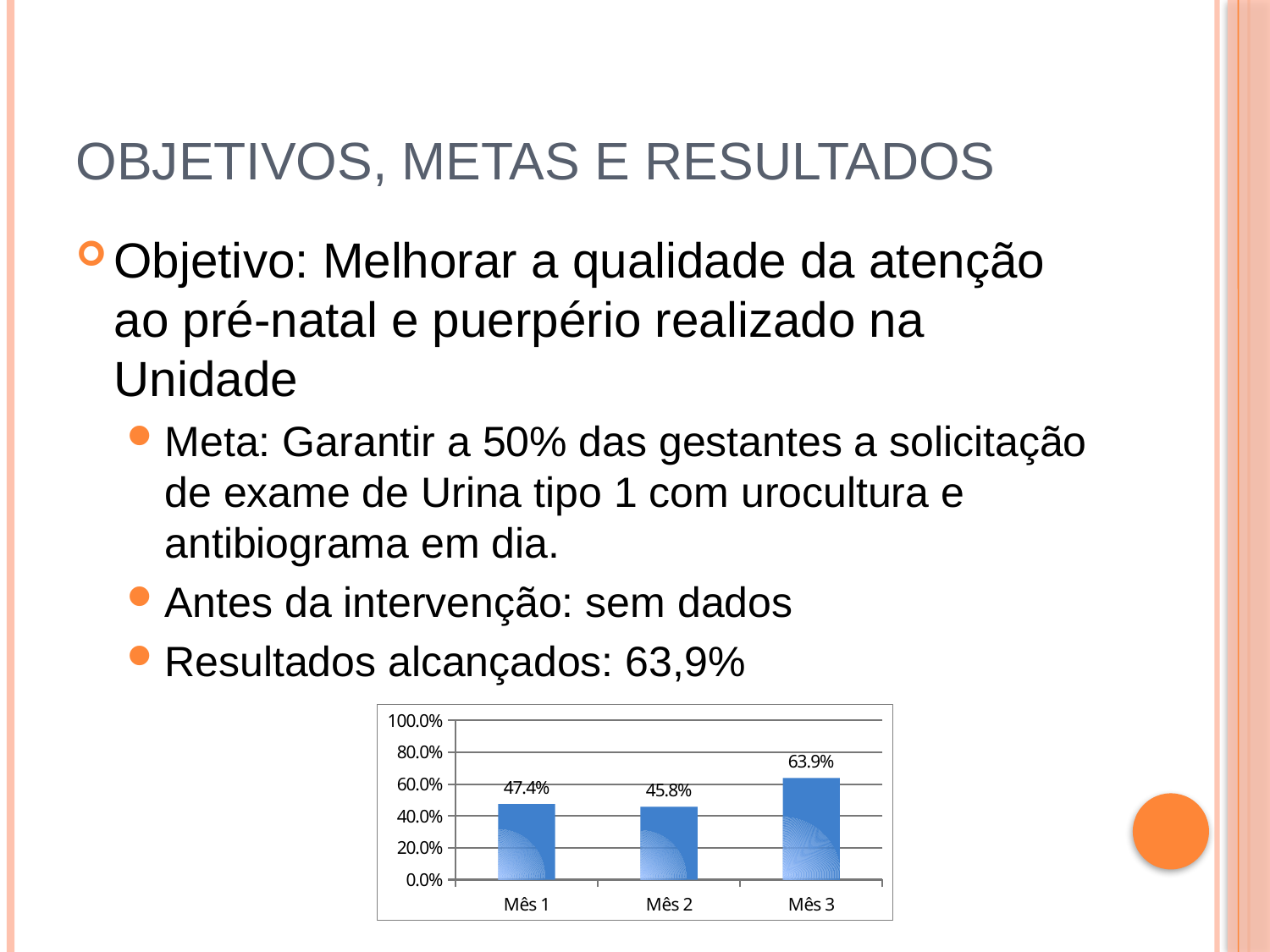
Which is larger, the value for Mês 3 or the value for Mês 2? Mês 3 What is the difference between the values for Mês 3 and Mês 1? 16.5% What is the difference between the values for Mês 1 and Mês 2? 1.6% How many months are shown on the x axis? 3 What is the value for Mês 2? 45.8% Which month has the lowest value? Mês 2 Is the value for Mês 3 greater or less than 60.0%? greater What kind of chart is shown on the slide? Bar chart What is the value for Mês 1? 47.4% Is the value for Mês 2 greater or less than 60.0%? less What is the value for Mês 3? 63.9% Which month has the highest value? Mês 3